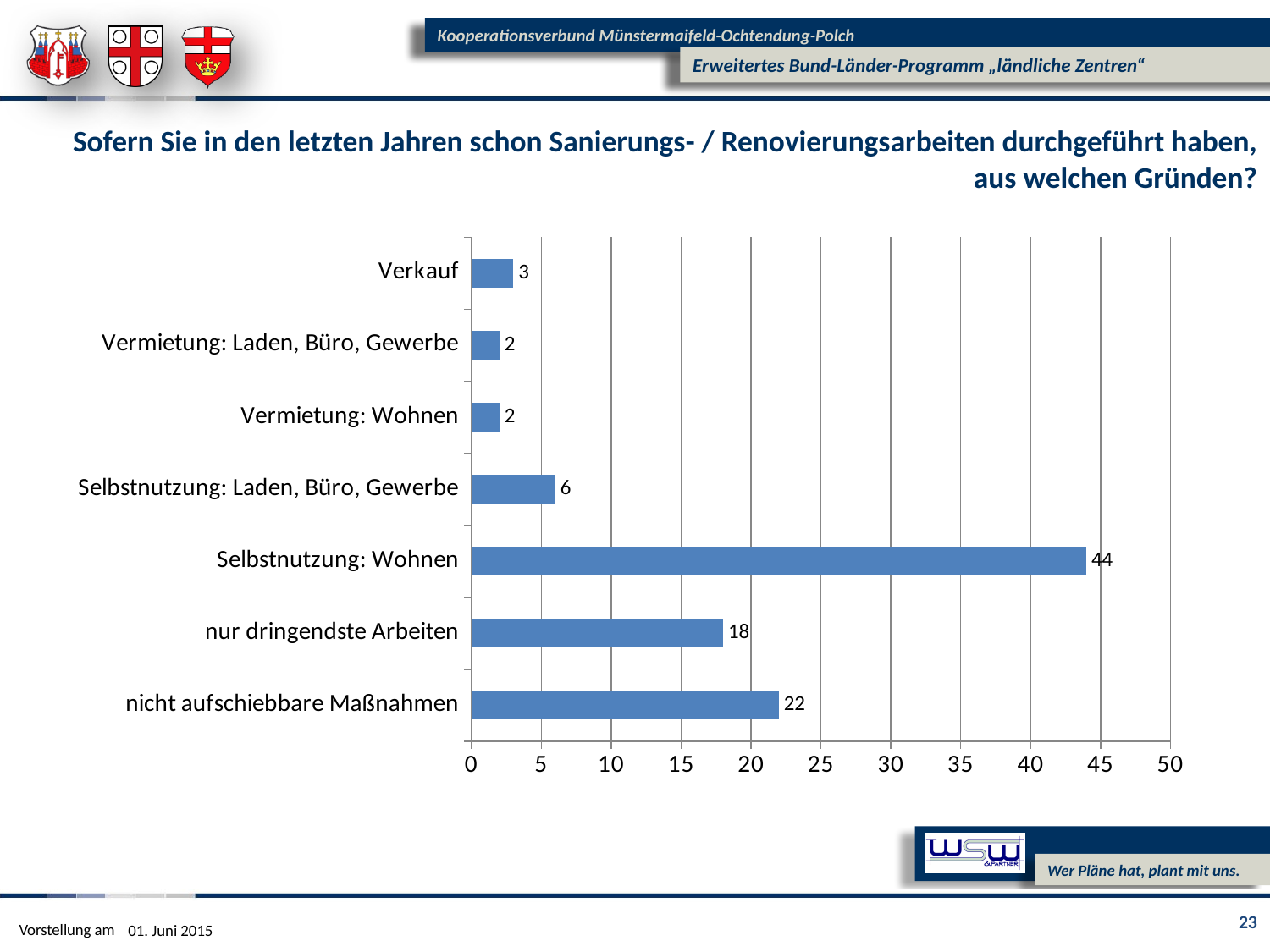
Which is larger, "nicht aufschiebbare Maßnahmen" or "nur dringendste Arbeiten"? nicht aufschiebbare Maßnahmen Is the value for "Selbstnutzung: Wohnen" greater or less than 40? greater What is the maximum value shown on the horizontal axis? 50 How many categories are shown in the chart? 7 What is the value for "Verkauf"? 3 Which category has the highest value? Selbstnutzung: Wohnen What kind of chart is shown on the slide? bar chart What is the value for "Selbstnutzung: Laden, Büro, Gewerbe"? 6 What is the value for "Selbstnutzung: Wohnen"? 44 What is the value for "nur dringendste Arbeiten"? 18 What is the difference between "nicht aufschiebbare Maßnahmen" and "nur dringendste Arbeiten"? 4 What is the difference between "Selbstnutzung: Wohnen" and "nicht aufschiebbare Maßnahmen"? 22